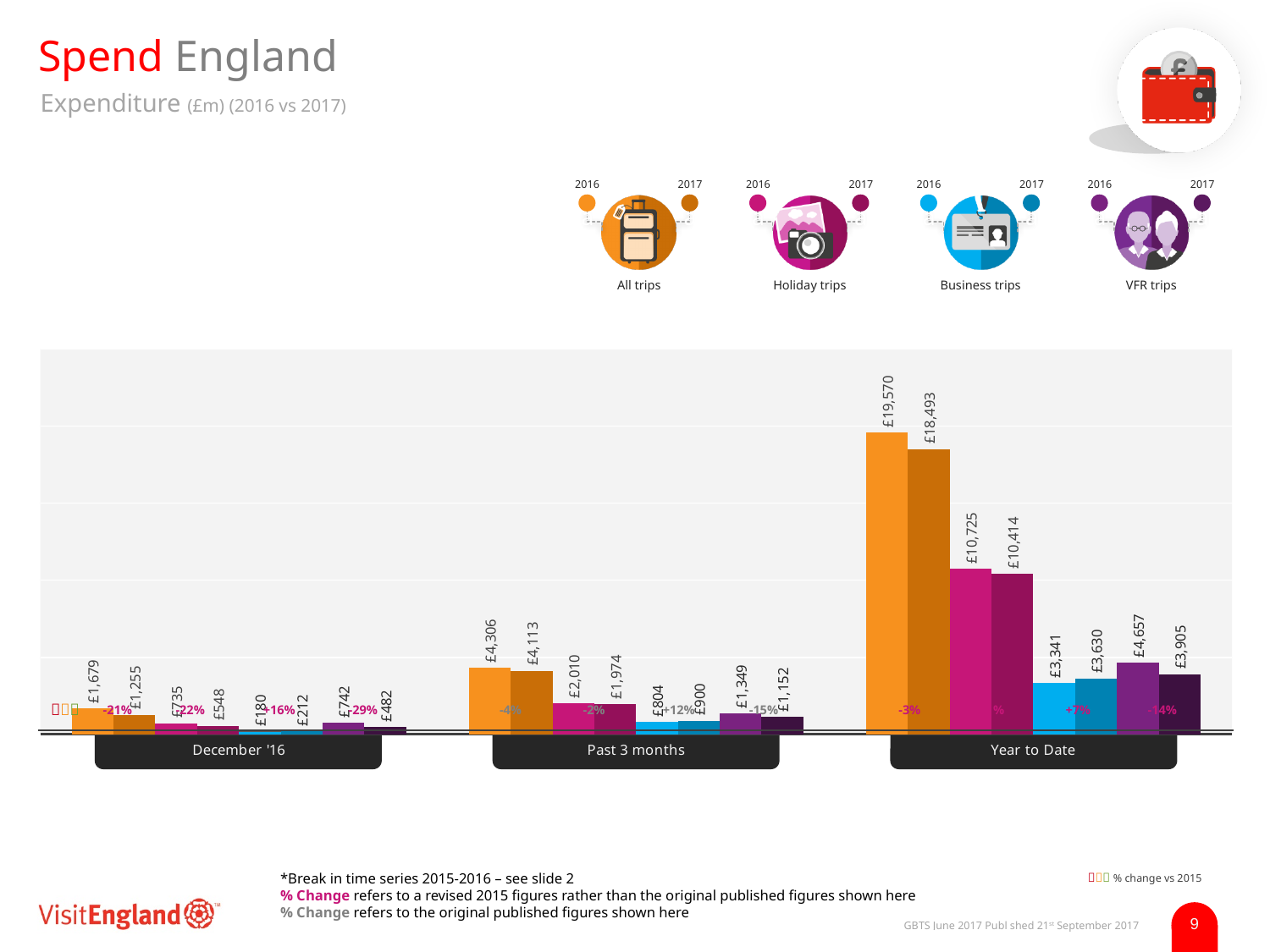
How many trip types does the legend list? 4 Which trip type has the highest expenditure for Year to Date in 2017? All trips What was the Business trips expenditure for December '16 in 2017? £212 Which is larger for Past 3 months: Business trips 2016 or Business trips 2017? Business trips 2017 What type of chart is shown on the slide? bar chart What was the Holiday trips expenditure for Past 3 months in 2017? £1,974 What was the VFR trips expenditure for Year to Date in 2017? £3,905 How many time-period categories are shown on the x axis? 3 What was the All trips expenditure for Year to Date in 2016? £19,570 Which trip type has the lowest expenditure for December '16 in 2016? Business trips What is the percentage change shown for All trips in December '16? -21% What is the difference between the 2016 and 2017 All trips expenditure for Year to Date? £1,077